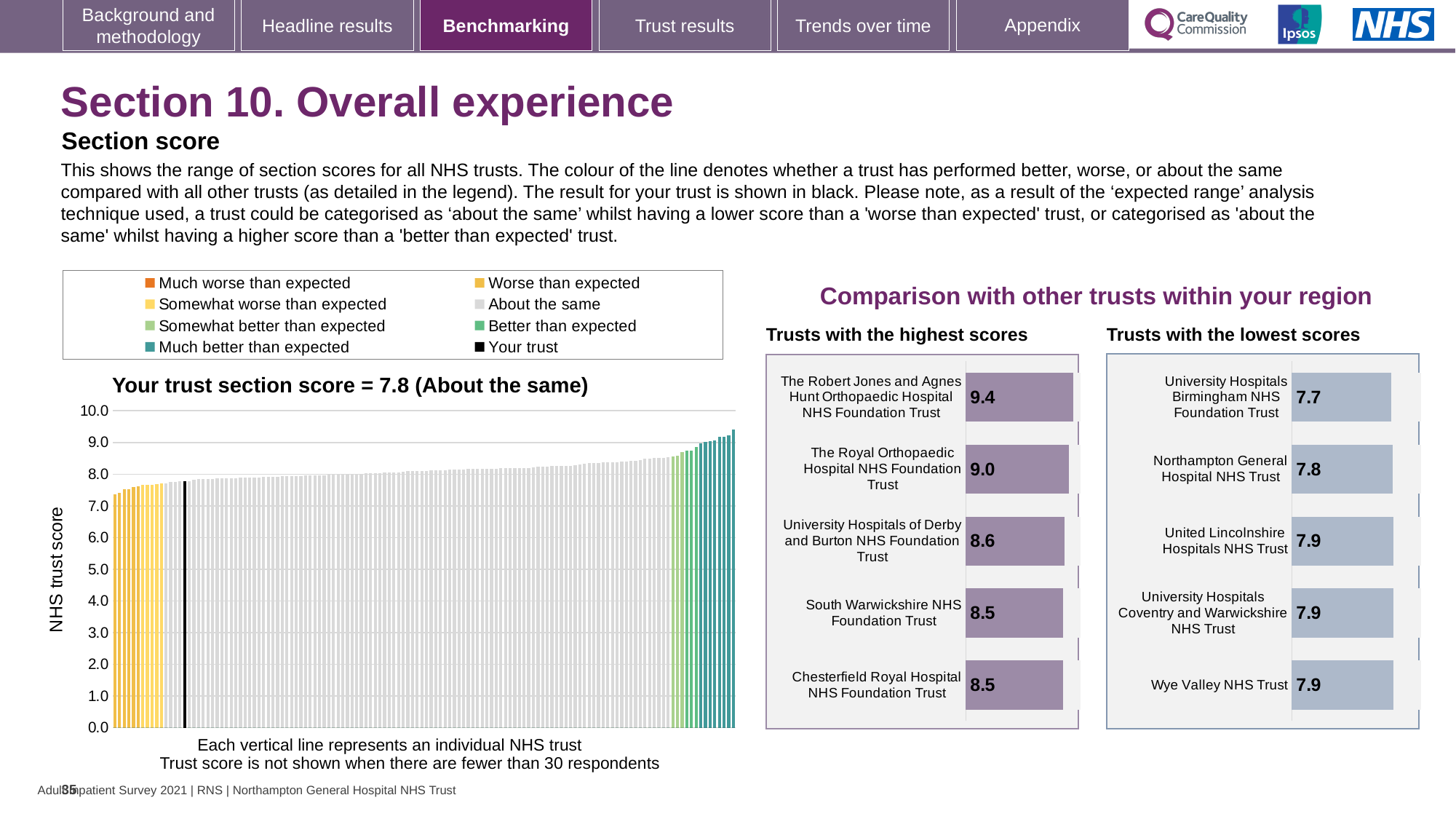
How many entries does the legend above the 'Your trust section score' chart list? 8 In the 'Trusts with the highest scores' chart, which trust has the highest score? The Robert Jones and Agnes Hunt Orthopaedic Hospital NHS Foundation Trust In the 'Your trust section score' chart, do the trust scores rise or fall from left to right? rise In the 'Trusts with the highest scores' chart, what is the difference between the scores of The Robert Jones and Agnes Hunt Orthopaedic Hospital NHS Foundation Trust and The Royal Orthopaedic Hospital NHS Foundation Trust? 0.4 In the 'Trusts with the lowest scores' chart, what is the score for Northampton General Hospital NHS Trust? 7.8 In the 'Your trust section score' chart, what is the section score for your trust? 7.8 In the 'Trusts with the highest scores' chart, what is the score for The Robert Jones and Agnes Hunt Orthopaedic Hospital NHS Foundation Trust? 9.4 In the 'Trusts with the lowest scores' chart, what is the difference between the scores of Wye Valley NHS Trust and University Hospitals Birmingham NHS Foundation Trust? 0.2 In the 'Trusts with the lowest scores' chart, which trust has the lowest score? University Hospitals Birmingham NHS Foundation Trust What kind of chart is the 'Your trust section score' chart? bar chart How many trusts are listed in the 'Trusts with the highest scores' chart? 5 In the 'Trusts with the highest scores' chart, which has the larger score: The Royal Orthopaedic Hospital NHS Foundation Trust or University Hospitals of Derby and Burton NHS Foundation Trust? The Royal Orthopaedic Hospital NHS Foundation Trust